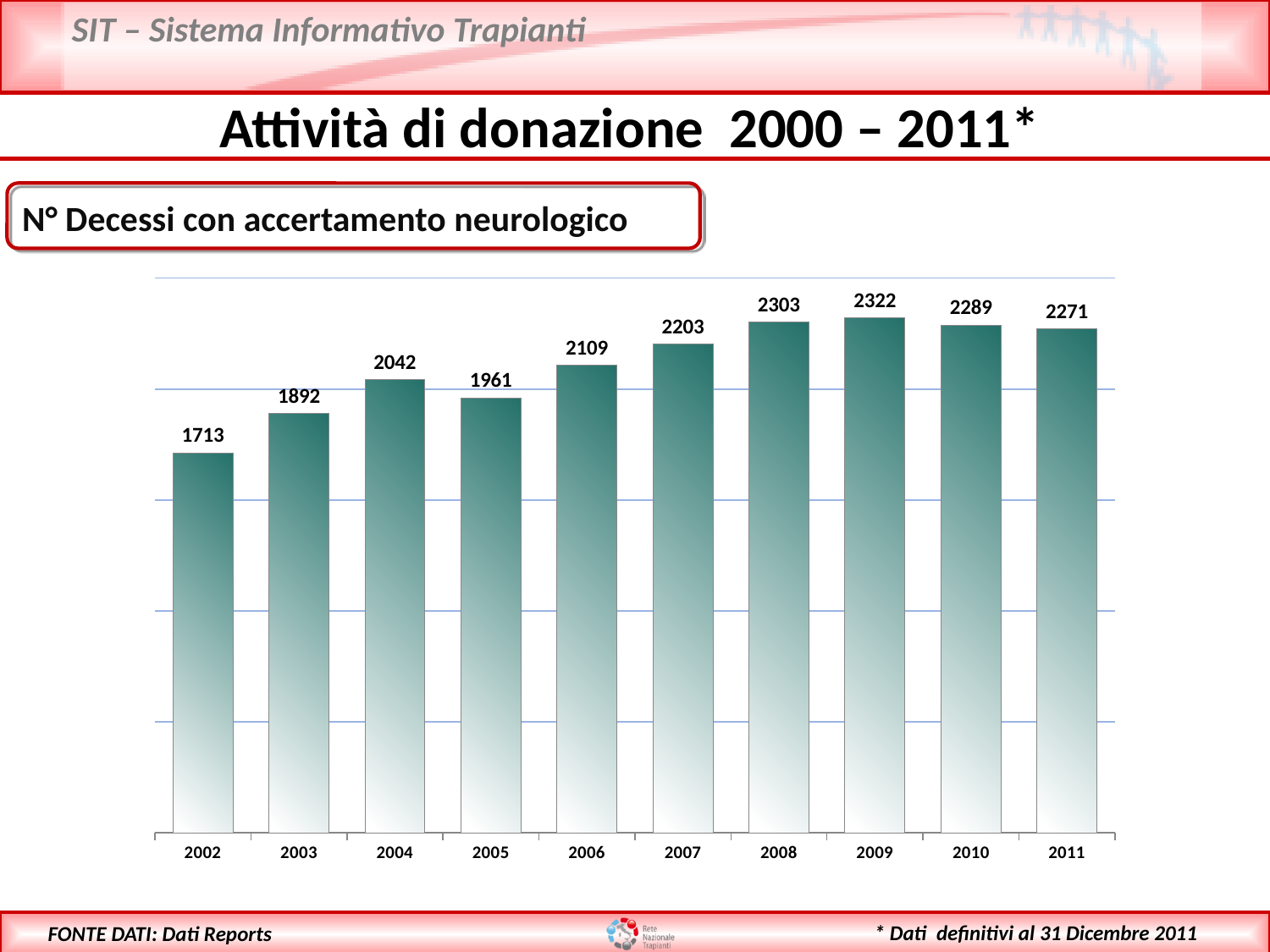
Which is larger, the value for 2004 or the value for 2005? 2004 What is the title of the chart? N° Decessi con accertamento neurologico What is the difference between the values for 2004 and 2005? 81 What is the value for 2009? 2322 How many years are shown on the x axis? 10 Which is larger, the value for 2010 or the value for 2011? 2010 What is the value for 2011? 2271 Which year has the highest value? 2009 What is the value for 2002? 1713 What kind of chart is shown? bar chart Which year has the lowest value? 2002 What is the difference between the values for 2009 and 2002? 609